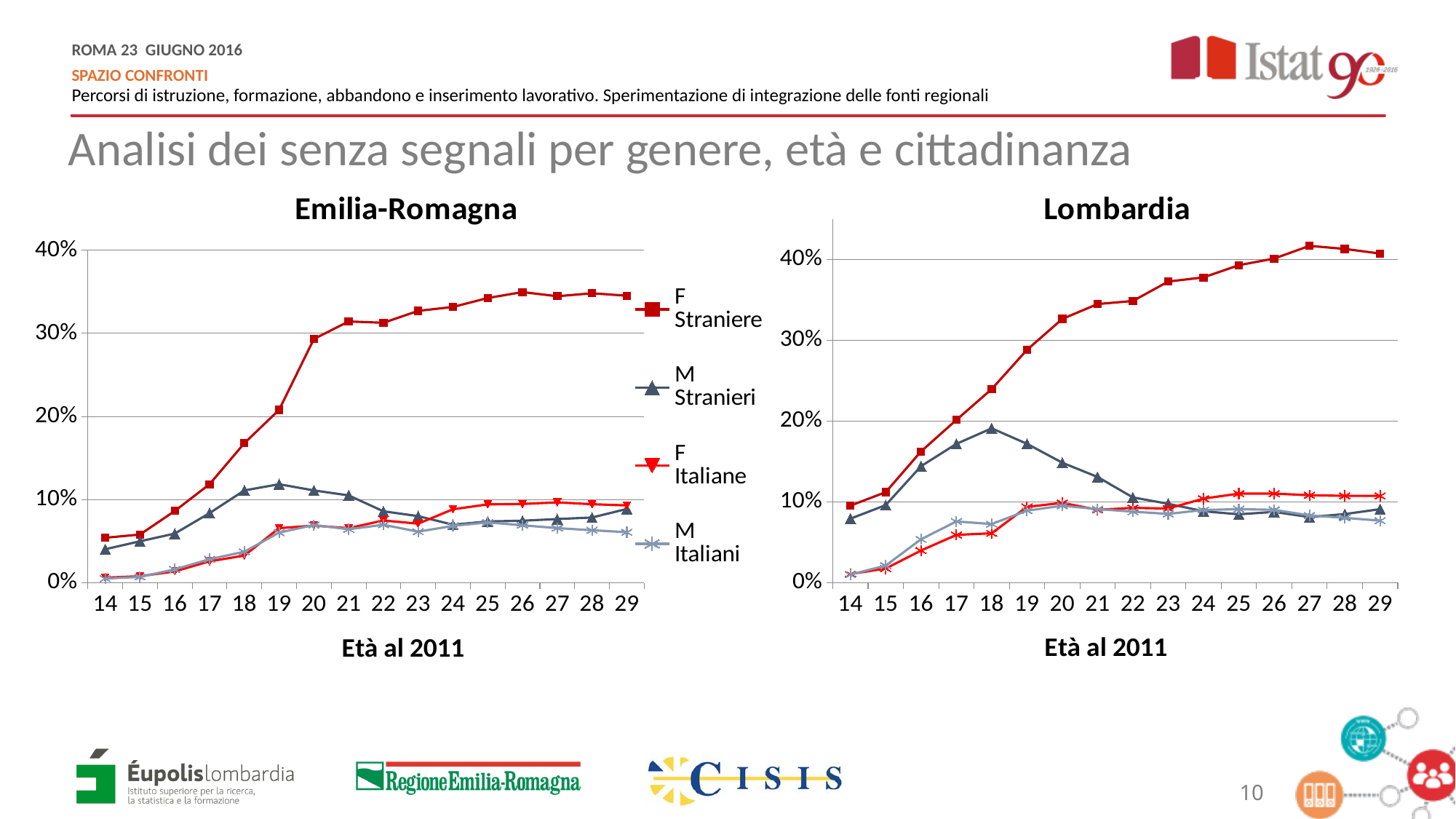
In the Lombardia chart, is the value for F Straniere at age 29 greater or less than 40%? greater What is the x-axis label of the Emilia-Romagna chart? Età al 2011 In the Emilia-Romagna chart, which series has the lowest value at age 29? M Italiani How many series does the legend list for the Emilia-Romagna chart? 4 How many age categories are shown on the x axis of the Lombardia chart? 16 In the Lombardia chart, is the value for F Straniere at age 20 larger or smaller than the value for M Stranieri at age 20? larger In the Lombardia chart, which series has the highest value at age 29? F Straniere In the Lombardia chart, is the value for M Stranieri at age 18 greater or less than 20%? less In the Lombardia chart, does the F Straniere series generally rise or fall from age 14 to age 27? rise In the Emilia-Romagna chart, is the value for M Stranieri at age 19 greater or less than 10%? greater What kind of chart is the Emilia-Romagna chart? line chart